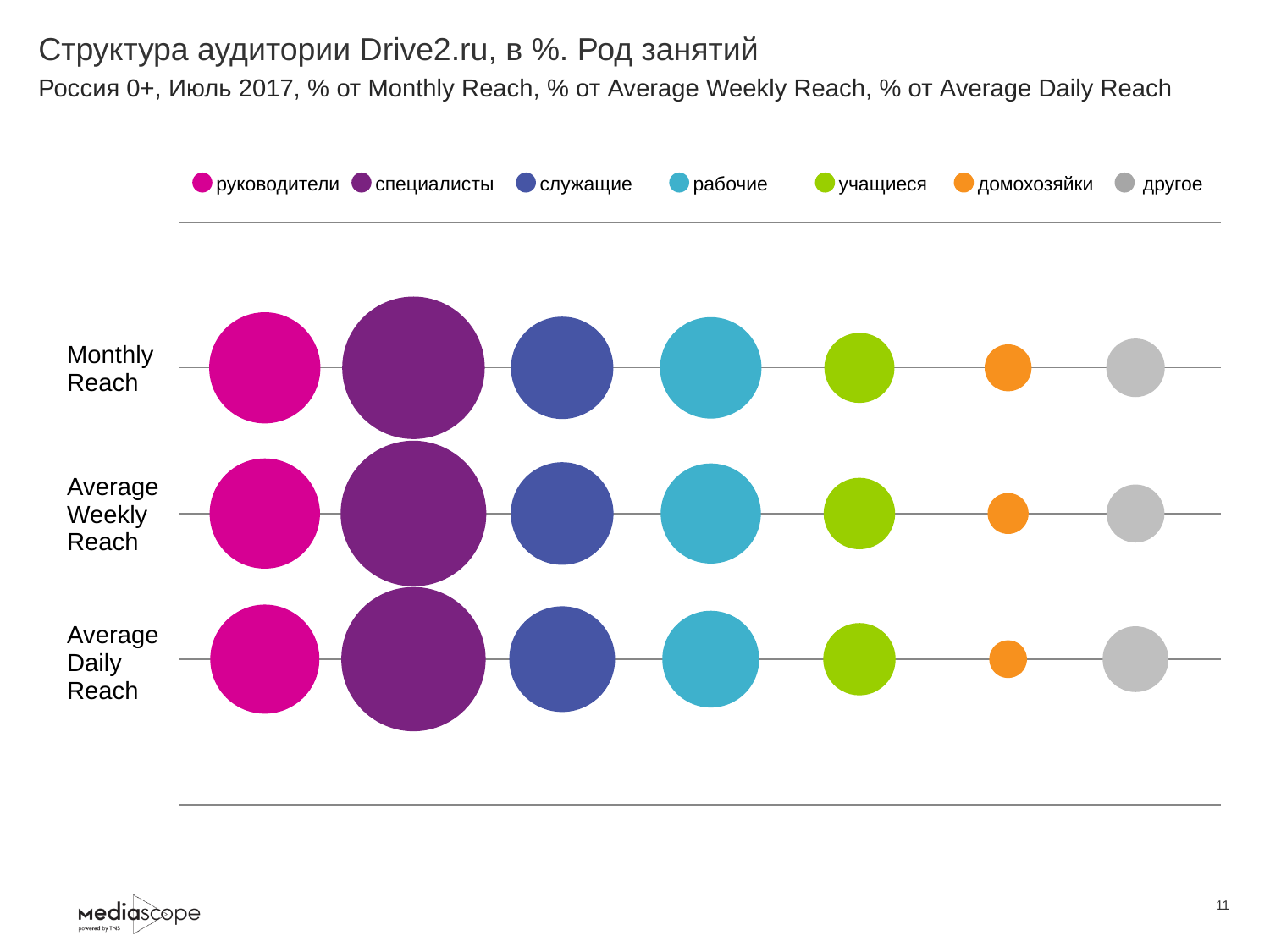
What colour represents специалисты in the chart? purple What kind of chart is shown on the slide? bubble chart Which occupation group has the largest bubble in the Monthly Reach row? специалисты In the Monthly Reach row, which bubble is larger: руководители or служащие? руководители How many reach categories (rows) are plotted on the chart? 3 What is the first entry in the chart legend? руководители Which occupation group has the smallest bubble in the Average Daily Reach row? домохозяйки Which occupation group has the largest bubble in the Average Weekly Reach row? специалисты In the Average Weekly Reach row, which bubble is larger: рабочие or учащиеся? рабочие In the Average Daily Reach row, which bubble is larger: другое or домохозяйки? другое How many series does the legend list? 7